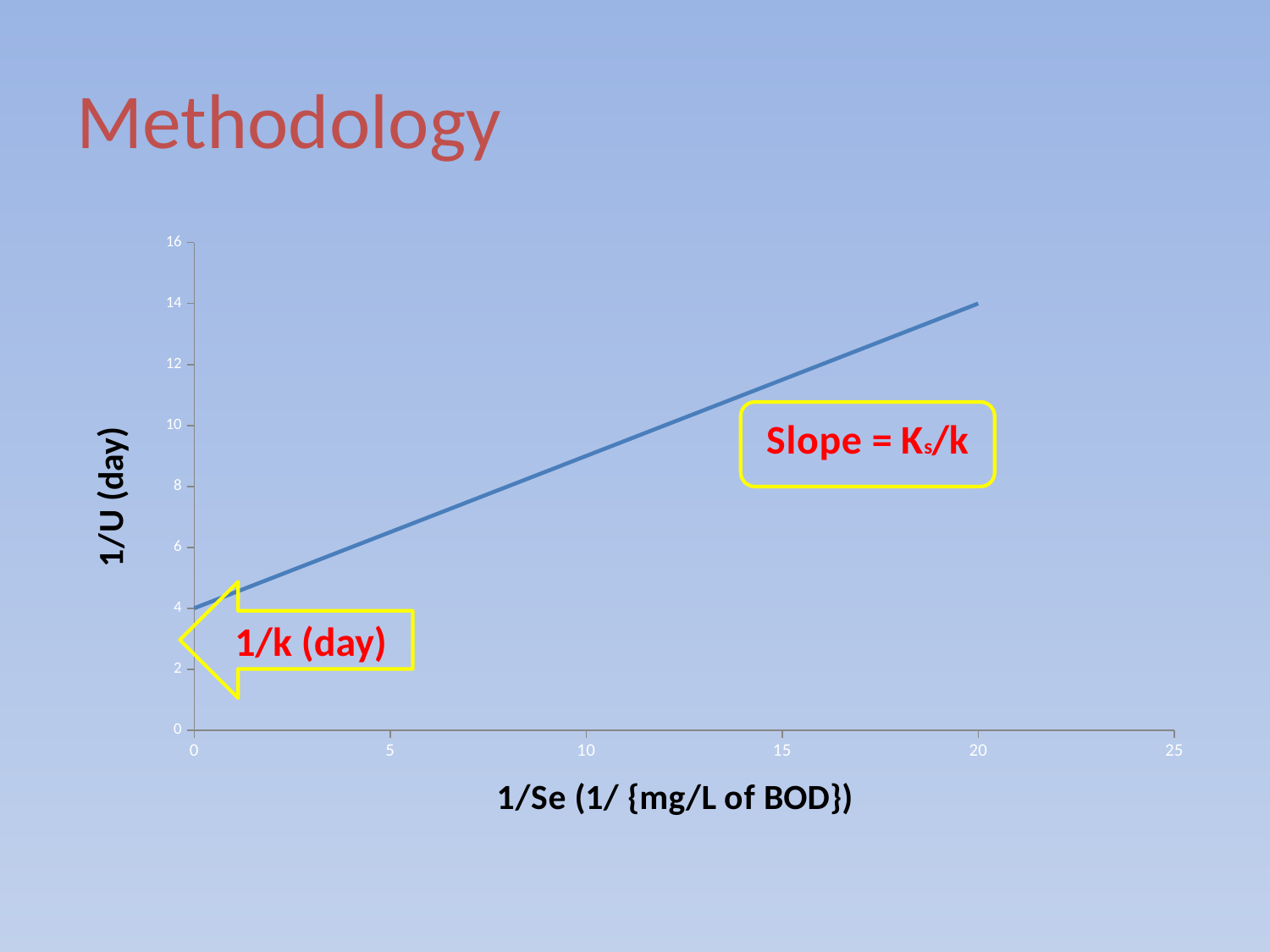
How many lines are plotted on the chart? 1 What is the label of the x axis? 1/Se (1/ {mg/L of BOD}) What is the value of 1/U at the right end of the line, where 1/Se = 20? 14 Is the value of 1/U at 1/Se = 5 greater or less than 8? less According to the annotation on the chart, what does the slope of the line equal? Ks/k What kind of chart is shown on the slide? line chart Is the value of 1/U at 1/Se = 15 greater or less than 10? greater Is the value of 1/U at 1/Se = 10 greater or less than 8? greater By how much does 1/U increase between 1/Se = 0 and 1/Se = 20? 10 Does the plotted line rise or fall as 1/Se increases along the x axis? rises What is the value of 1/U where the line meets the y axis at 1/Se = 0? 4 Which is larger, the value of 1/U at 1/Se = 0 or at 1/Se = 20? 1/Se = 20